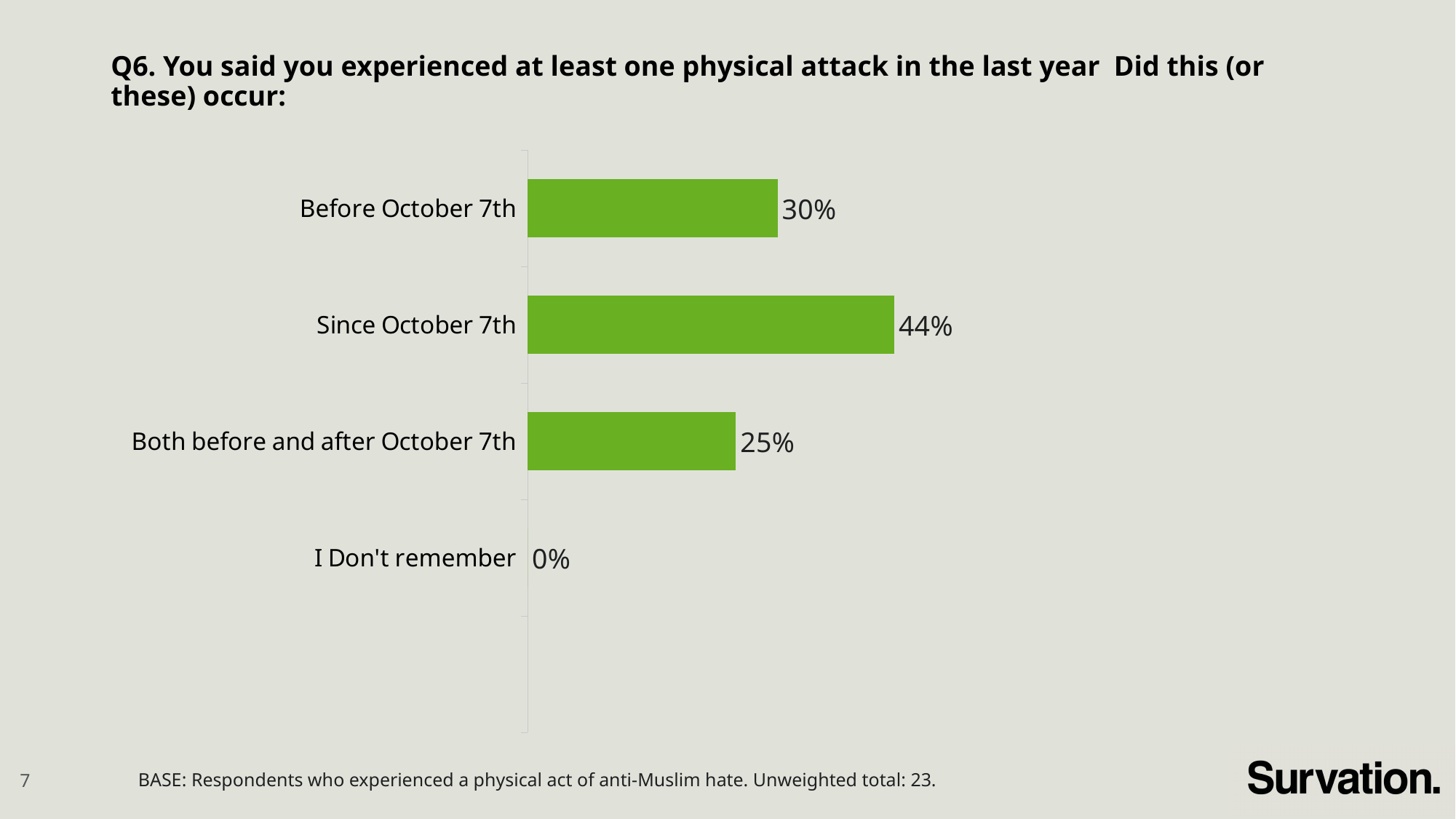
What percentage of respondents said the attack occurred since October 7th? 44% Which category has the lowest value? I Don't remember What kind of chart is shown on the slide? Bar chart What is the difference between the values for 'Before October 7th' and 'Both before and after October 7th'? 5% What percentage of respondents said the attack occurred before October 7th? 30% Which is larger: the value for 'Before October 7th' or 'Both before and after October 7th'? Before October 7th What is the difference between the values for 'Since October 7th' and 'Before October 7th'? 14% Which category has the highest value? Since October 7th How many categories are shown in the chart? 4 What is the value for 'Both before and after October 7th'? 25% What is the value for 'I Don't remember'? 0% What colour are the bars in the chart? Green